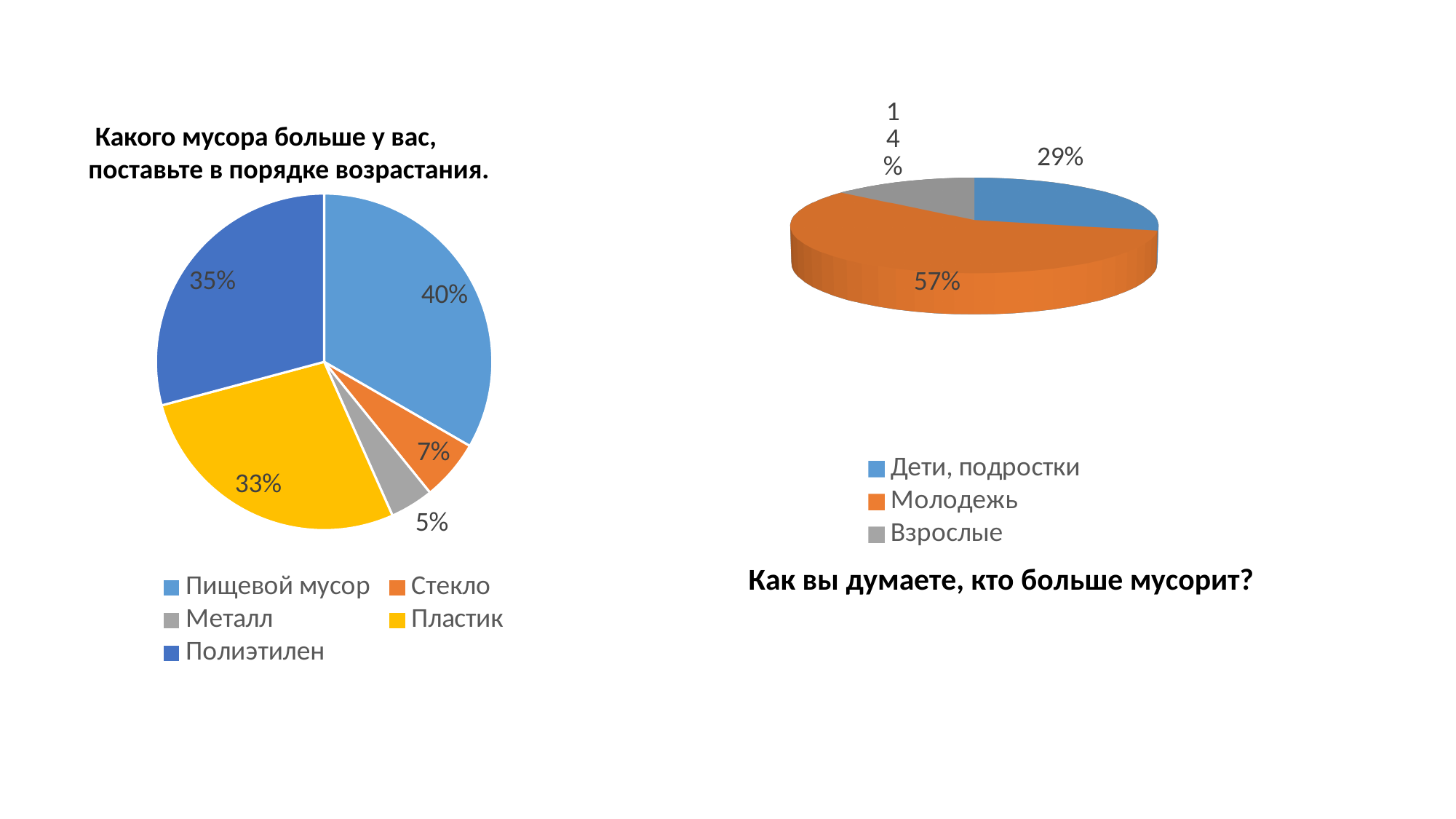
How many categories does the left pie chart show? 5 In the left pie chart, what share does Металл have? 5% In the right pie chart, what is the difference between the shares of Молодежь and Дети, подростки? 28% In the right pie chart ("Как вы думаете, кто больше мусорит?"), what share does Молодежь have? 57% In the left pie chart ("Какого мусора больше у вас"), what share does Пищевой мусор have? 40% In the left pie chart, what is the difference between the shares of Полиэтилен and Пластик? 2% In the left pie chart, which is larger: Стекло or Металл? Стекло What type of chart is the right chart? Pie chart In the right pie chart, which group has the largest slice? Молодежь In the left pie chart, which category has the smallest slice? Металл In the right pie chart, what share does Взрослые have? 14% In the left pie chart, which category has the largest slice? Пищевой мусор